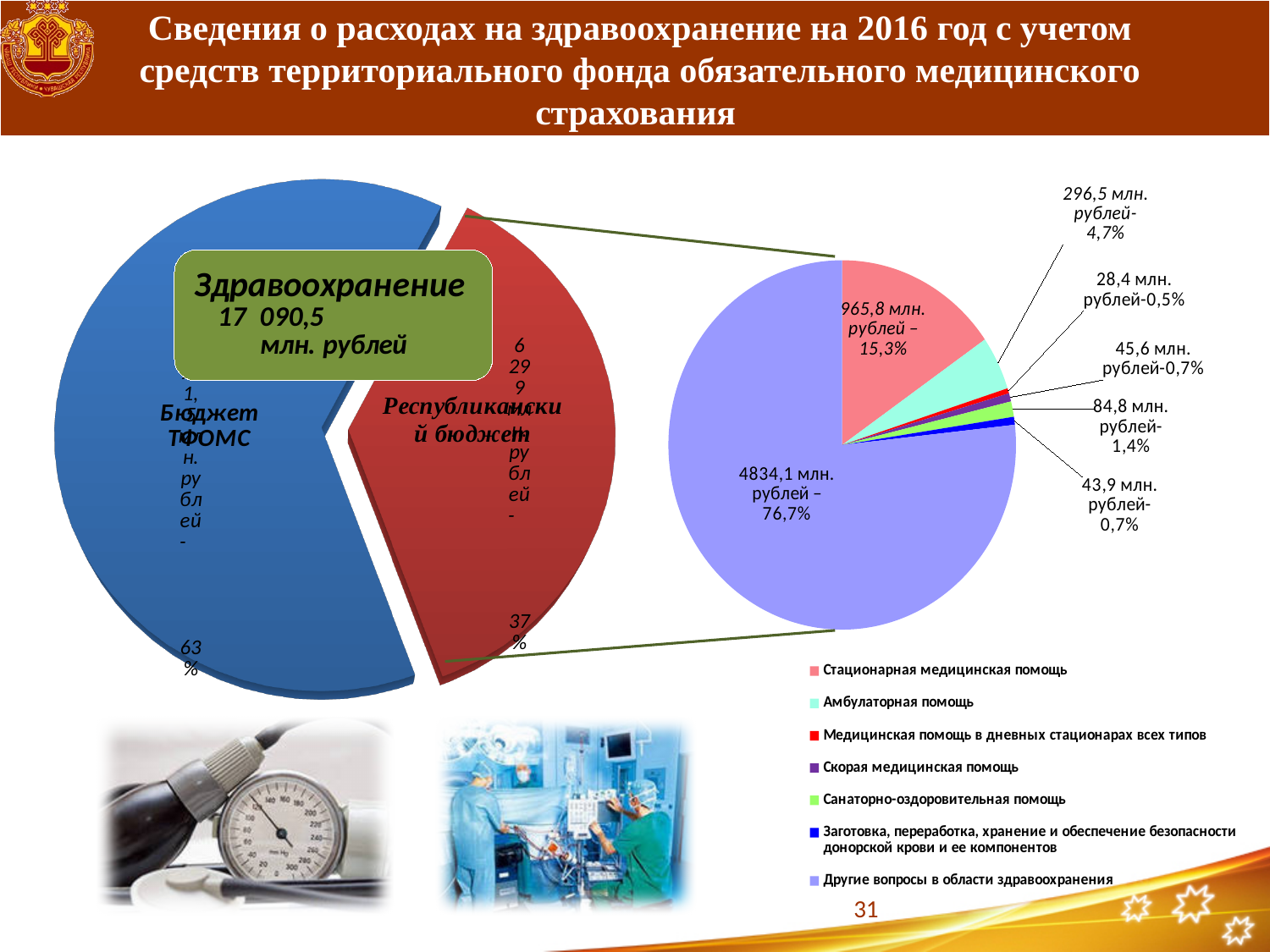
What type of chart is the right-hand chart on the slide? pie chart In the right pie chart, what is the value of the largest slice? 4834,1 млн. рублей In the left pie chart, what share does Республиканский бюджет have? 37% What total amount for Здравоохранение is shown in the centre of the left pie chart? 17 090,5 млн. рублей In the right pie chart, what is the difference between the 965,8 млн. рублей slice and the 296,5 млн. рублей slice? 669,3 млн. рублей In the left pie chart, what share does Бюджет ТФОМС have? 63% In the right pie chart, what is the smallest value shown among the slices? 28,4 млн. рублей In the left pie chart, which of the two slices is larger: Бюджет ТФОМС or Республиканский бюджет? Бюджет ТФОМС In the right pie chart, what share does Стационарная медицинская помощь have? 15,3% How many entries does the legend of the right pie chart list? 7 In the right pie chart, what is the value of the Стационарная медицинская помощь slice? 965,8 млн. рублей